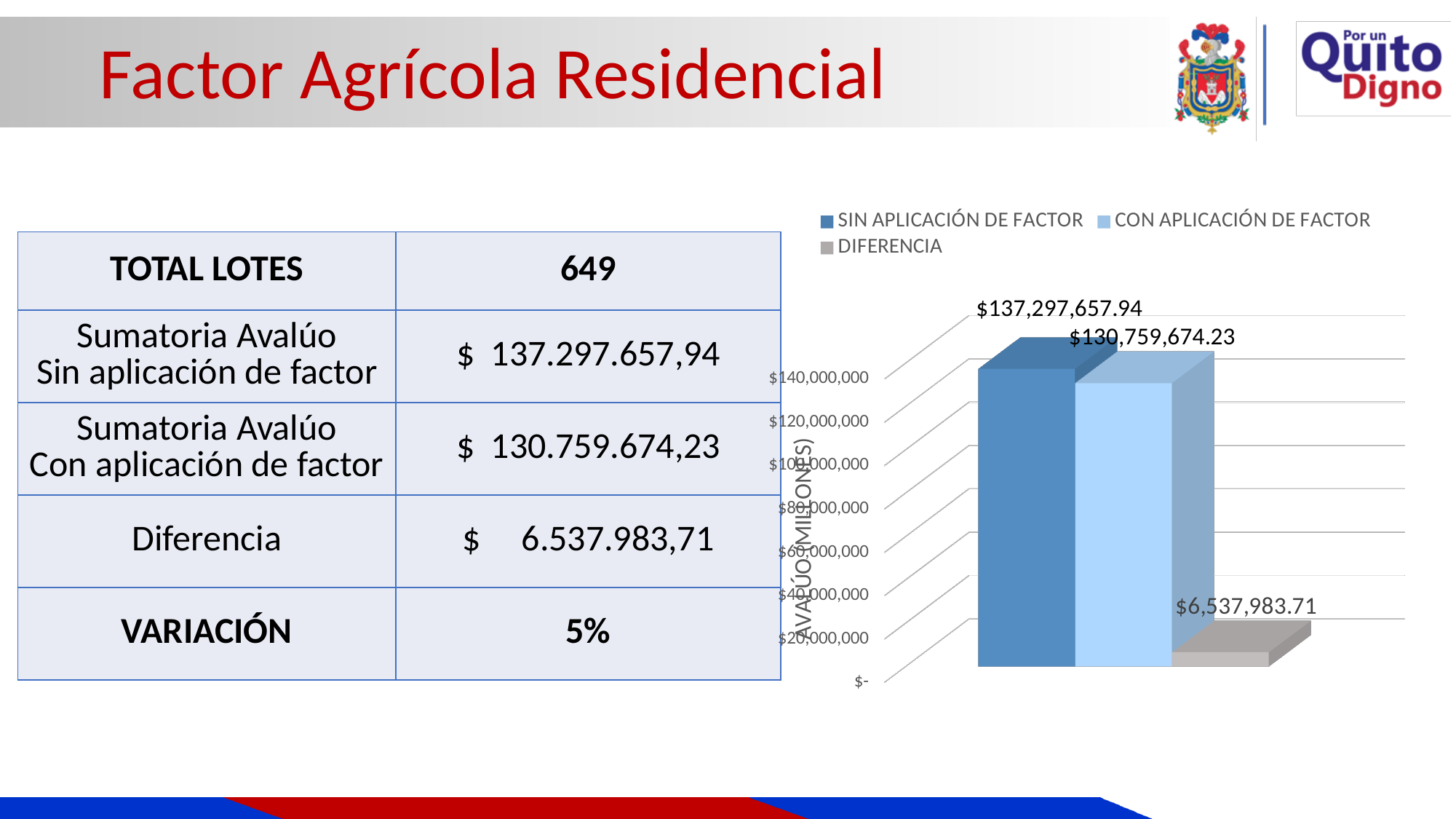
What colour is the DIFERENCIA series in the chart legend? Grey Is the value of the CON APLICACIÓN DE FACTOR bar greater or less than $120,000,000? greater What kind of chart is shown on the slide? Bar chart What is the value of the SIN APLICACIÓN DE FACTOR bar in the chart? $137,297,657.94 Which series has the highest value in the chart? SIN APLICACIÓN DE FACTOR What is the label of the vertical axis of the chart? AVALÚO (MILLONES) How many series does the chart legend list? 3 Which is larger in the chart, SIN APLICACIÓN DE FACTOR or CON APLICACIÓN DE FACTOR? SIN APLICACIÓN DE FACTOR What is the value of the CON APLICACIÓN DE FACTOR bar in the chart? $130,759,674.23 Which series has the lowest value in the chart? DIFERENCIA Is the value of the DIFERENCIA bar greater or less than $20,000,000? less What is the value of the DIFERENCIA bar in the chart? $6,537,983.71